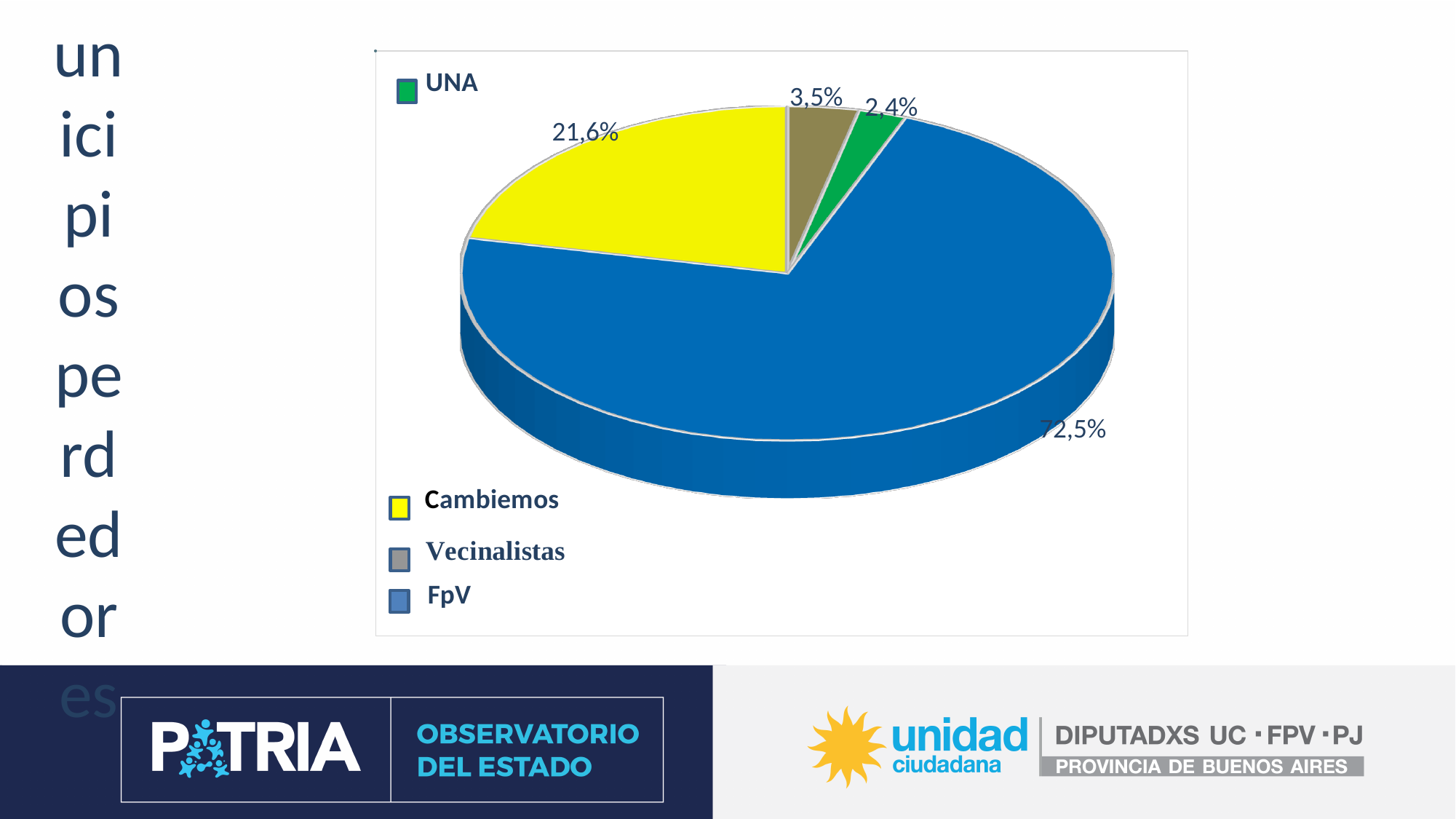
What kind of chart is shown on the slide? pie chart How many entries does the legend list? 4 What share of the pie does Vecinalistas have? 3,5% Which category has the smallest slice of the pie? UNA What is the difference in percentage points between FpV and Cambiemos? 50,9 What share of the pie does UNA have? 2,4% What share of the pie does FpV have? 72,5% Which category has the largest slice of the pie? FpV Which is larger, the share for Vecinalistas or the share for UNA? Vecinalistas What colour is the slice for Cambiemos? yellow What share of the pie does Cambiemos have? 21,6% How many slices does the pie chart have? 4